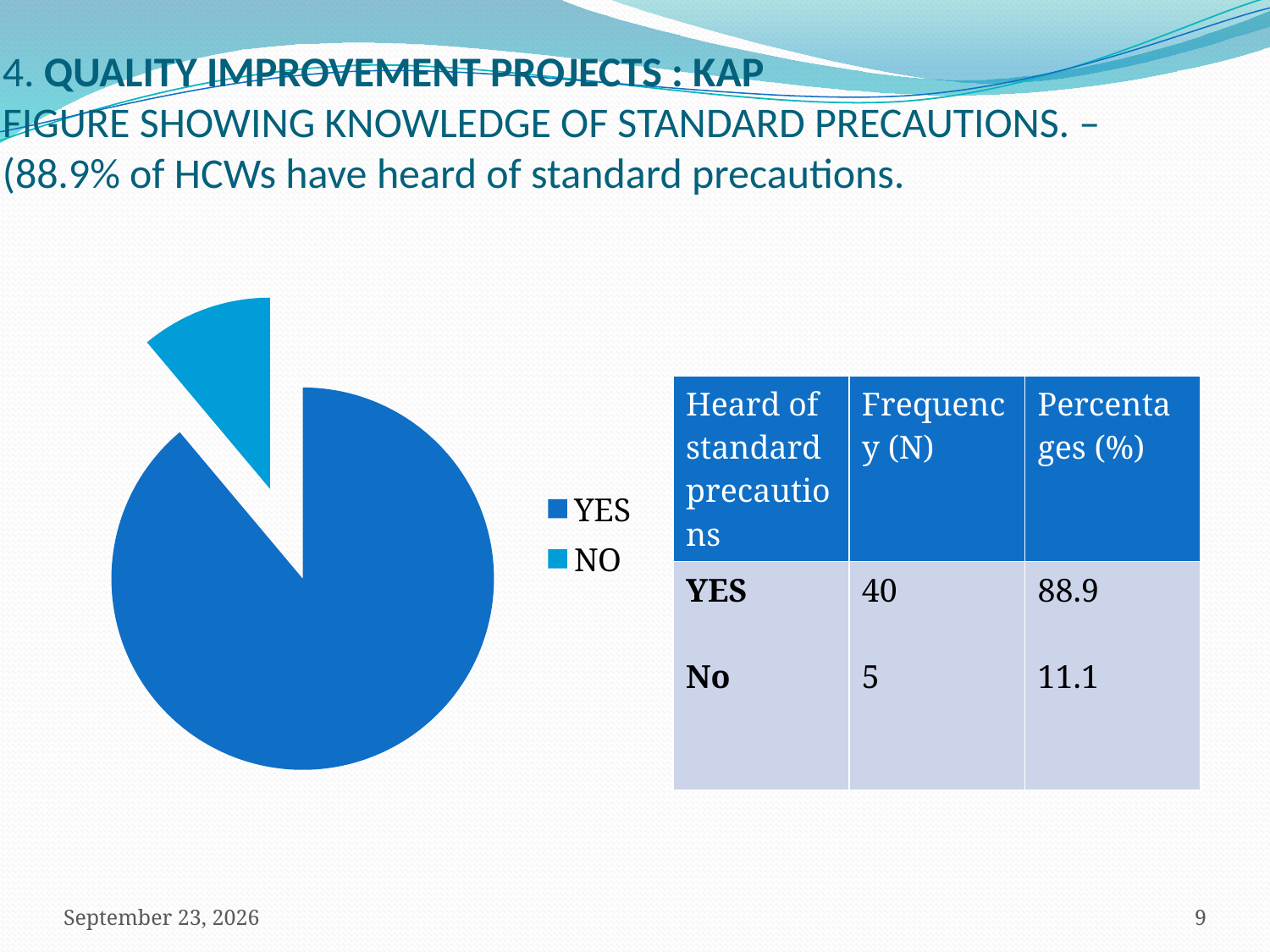
Which slice is larger in the pie chart, YES or NO? YES Which category has the largest slice in the pie chart? YES What share of the pie does the YES slice represent, according to the slide? 88.9% What are the two legend entries of the pie chart? YES and NO Which category has the smallest slice in the pie chart? NO Is the YES slice greater or less than half of the pie? greater What share of the pie does the NO slice represent, according to the slide? 11.1% How many entries does the pie chart's legend list? 2 Which slice of the pie chart is pulled out (exploded) from the rest? NO What kind of chart is shown on the slide? pie chart How many slices does the pie chart have? 2